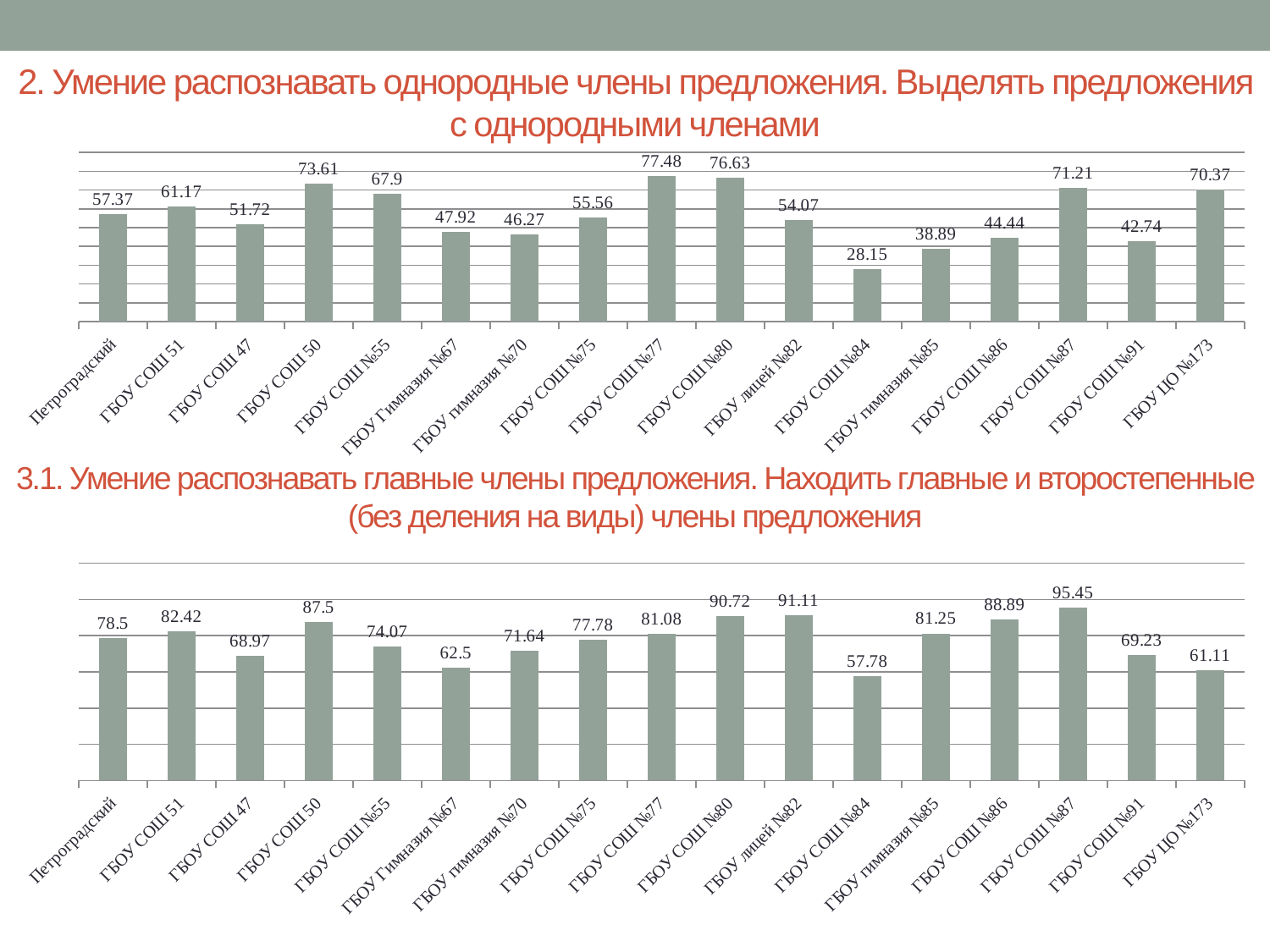
In the top chart (2. Умение распознавать однородные члены предложения), how many categories are plotted? 17 In the top chart (2. Умение распознавать однородные члены предложения), which category has the lowest value? ГБОУ СОШ №84 In the bottom chart (3.1. Умение распознавать главные члены предложения), what is the value for ГБОУ лицей №82? 91.11 In the bottom chart (3.1. Умение распознавать главные члены предложения), which category has the lowest value? ГБОУ СОШ №84 In the top chart (2. Умение распознавать однородные члены предложения), what is the difference between the values for ГБОУ СОШ 50 and ГБОУ СОШ 47? 21.89 What type of chart is the bottom chart (3.1. Умение распознавать главные члены предложения)? Bar chart In the top chart (2. Умение распознавать однородные члены предложения), which category has the highest value? ГБОУ СОШ №77 In the top chart (2. Умение распознавать однородные члены предложения), which is larger: the value for ГБОУ СОШ №87 or ГБОУ ЦО №173? ГБОУ СОШ №87 In the bottom chart (3.1. Умение распознавать главные члены предложения), which is larger: the value for ГБОУ СОШ №80 or ГБОУ СОШ №86? ГБОУ СОШ №80 In the bottom chart (3.1. Умение распознавать главные члены предложения), what is the difference between the values for Петроградский and ГБОУ Гимназия №67? 16 In the top chart (2. Умение распознавать однородные члены предложения), what is the value for ГБОУ СОШ №84? 28.15 In the bottom chart (3.1. Умение распознавать главные члены предложения), which category has the highest value? ГБОУ СОШ №87